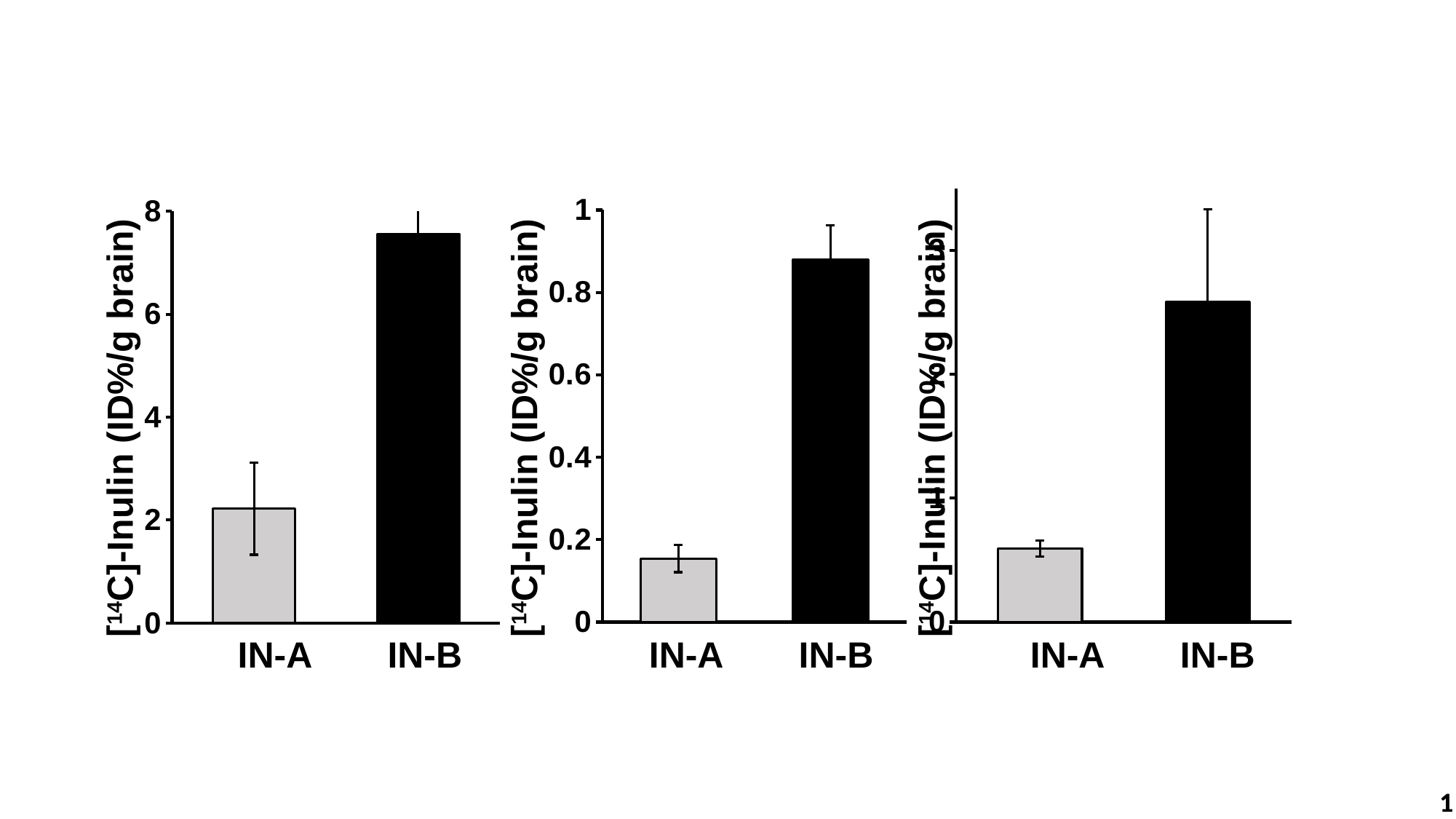
In the right chart, which category has the highest value? IN-B In the middle chart, is the value for IN-B greater or less than 0.8? greater In the middle chart, which category has the lowest value? IN-A What is the y-axis label of the middle chart? [14C]-Inulin (ID%/g brain) How many bar charts are shown on the slide? 3 What kind of chart is the left chart on the slide? bar chart In the left chart, is the value for IN-B greater or less than 6? greater What is the highest tick value on the y axis of the left chart? 8 How many categories are shown on the x axis of the middle chart? 2 In the middle chart, is the value for IN-A greater or less than 0.2? less In the left chart, which category has the higher value, IN-A or IN-B? IN-B